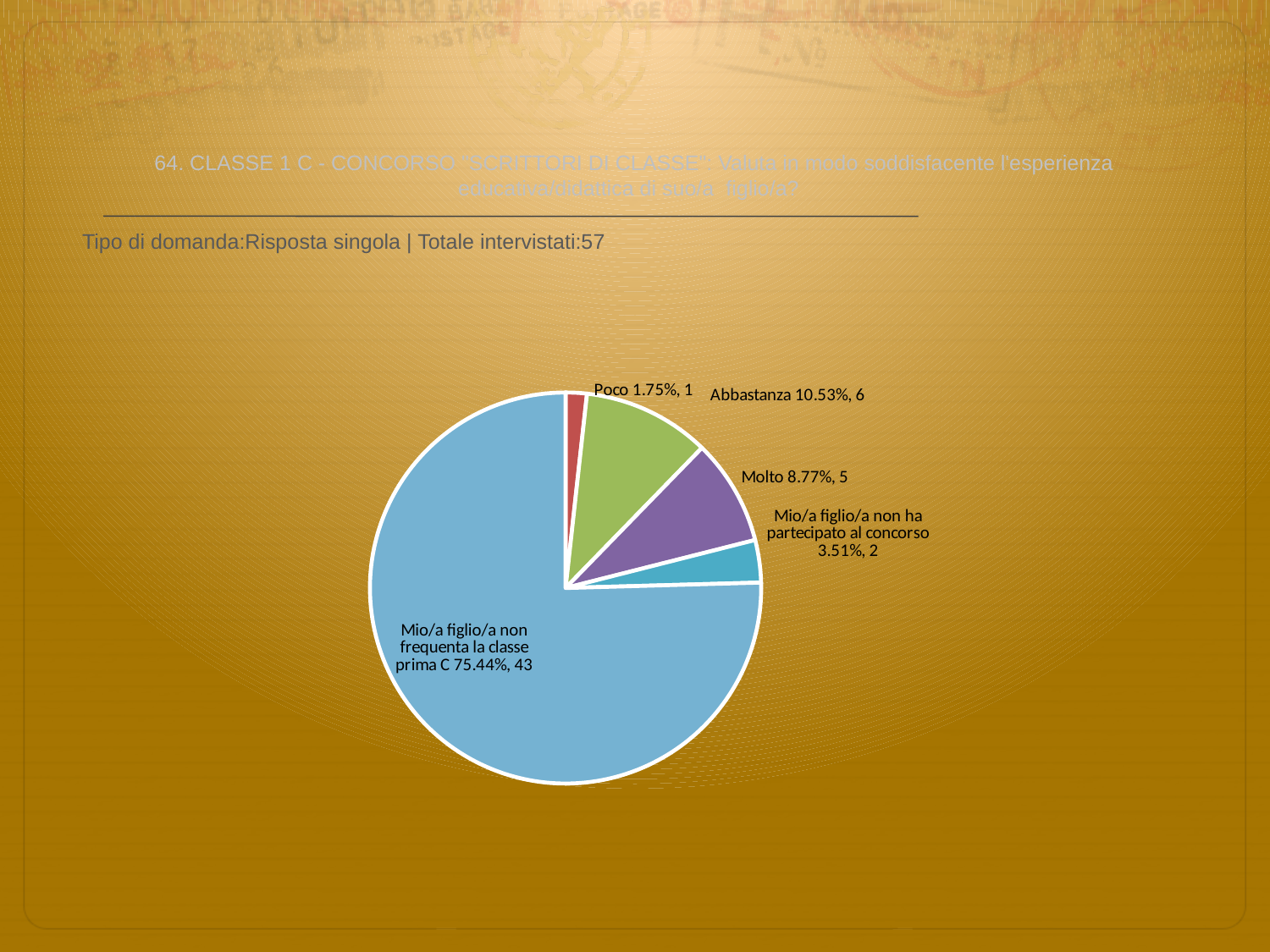
How many slices does the pie chart have? 5 Which slice is the largest in the pie chart? Mio/a figlio/a non frequenta la classe prima C What kind of chart is shown on the slide? Pie chart What share of the pie does "Mio/a figlio/a non frequenta la classe prima C" represent? 75.44% Which slice is the smallest in the pie chart? Poco How many respondents are in the "Mio/a figlio/a non ha partecipato al concorso" slice? 2 How many respondents answered "Molto"? 5 What percentage is shown for the "Abbastanza" slice? 10.53% What percentage is shown for the "Poco" slice? 1.75% Which slice is larger, "Abbastanza" or "Molto"? Abbastanza What is the difference in respondent count between "Abbastanza" and "Molto"? 1 What is the total number of respondents (Totale intervistati) stated on the slide? 57